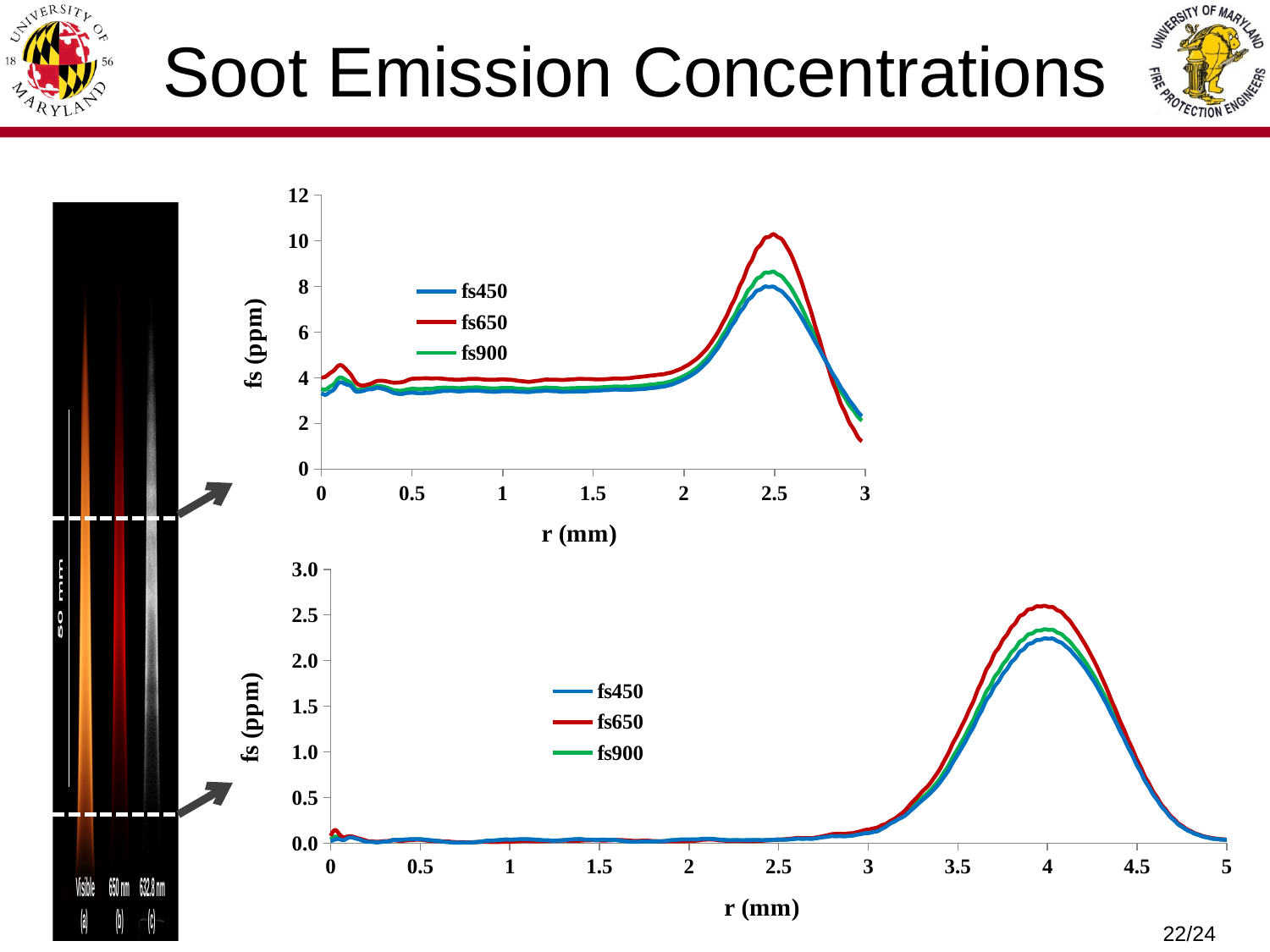
In the top chart, at r = 2.5 mm, which is larger, fs650 or fs450? fs650 What are the legend entries of the bottom chart? fs450, fs650, fs900 In the top chart, is the peak value of fs650 greater or less than 8? greater What kind of chart is the top chart on the slide? line chart In the top chart, which series has the lowest peak value? fs450 In the bottom chart, is the peak value of fs650 greater or less than 2.5? greater In the top chart, which series reaches the highest peak value? fs650 How many series does the legend of the top chart list? 3 What is the x-axis label of the bottom chart? r (mm) In the bottom chart, is the peak value of fs450 greater or less than 2.5? less In the bottom chart, which series reaches the highest peak value? fs650